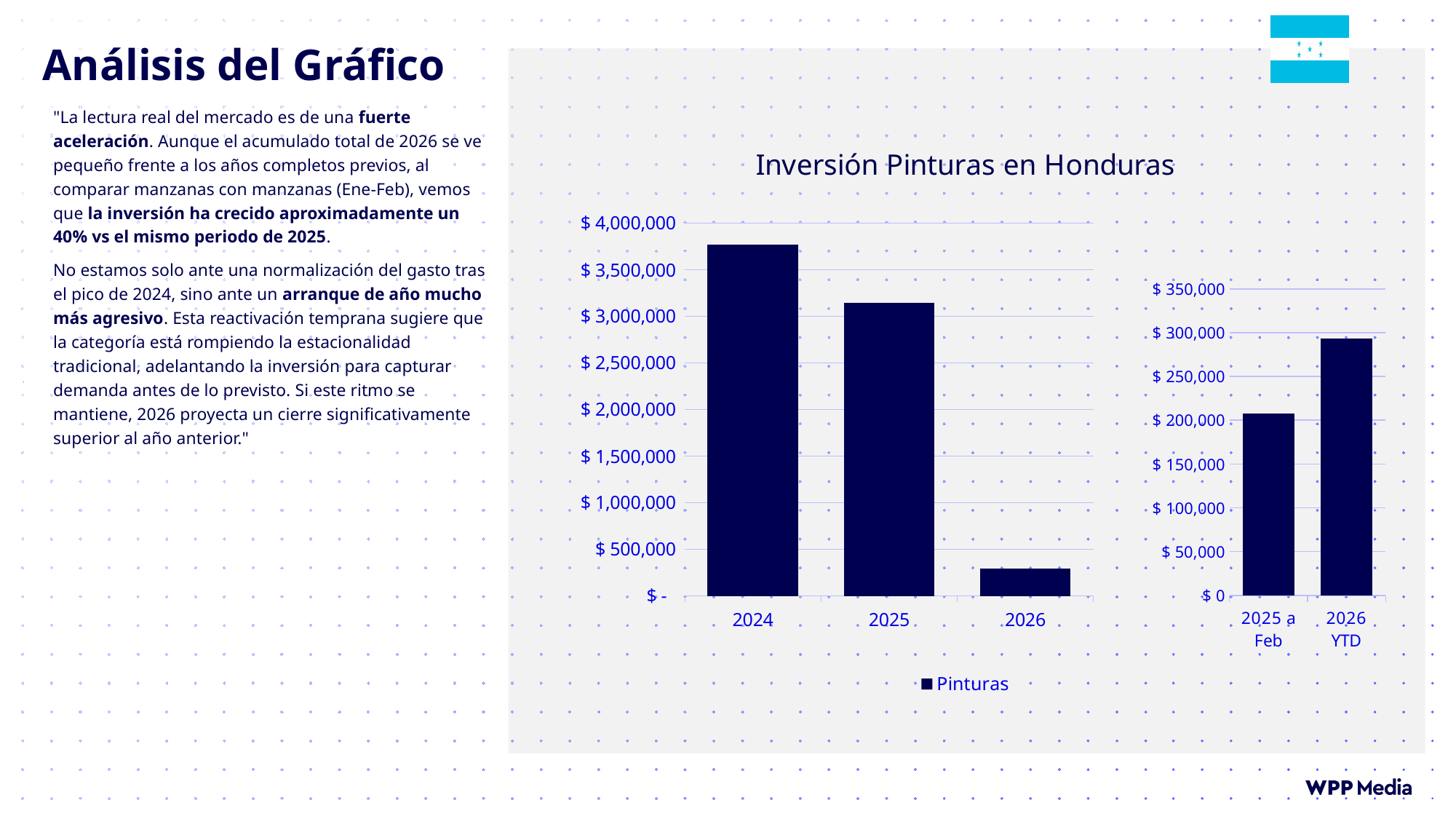
In the 'Inversión Pinturas en Honduras' chart, is the value for 2026 greater or less than $ 500,000? less In the 'Inversión Pinturas en Honduras' chart, which year has the lowest investment? 2026 In the smaller chart on the right of the slide, is the value for 2025 a Feb greater or less than $ 250,000? less In the 'Inversión Pinturas en Honduras' chart, do the values rise or fall from 2024 to 2026? fall In the smaller chart on the right of the slide, which is larger: 2025 a Feb or 2026 YTD? 2026 YTD In the 'Inversión Pinturas en Honduras' chart, is the value for 2025 greater or less than $ 3,500,000? less How many series does the legend of the 'Inversión Pinturas en Honduras' chart list? 1 In the 'Inversión Pinturas en Honduras' chart, which year has the highest investment? 2024 In the 'Inversión Pinturas en Honduras' chart, how many years are shown on the x axis? 3 What kind of chart is the 'Inversión Pinturas en Honduras' chart? bar chart